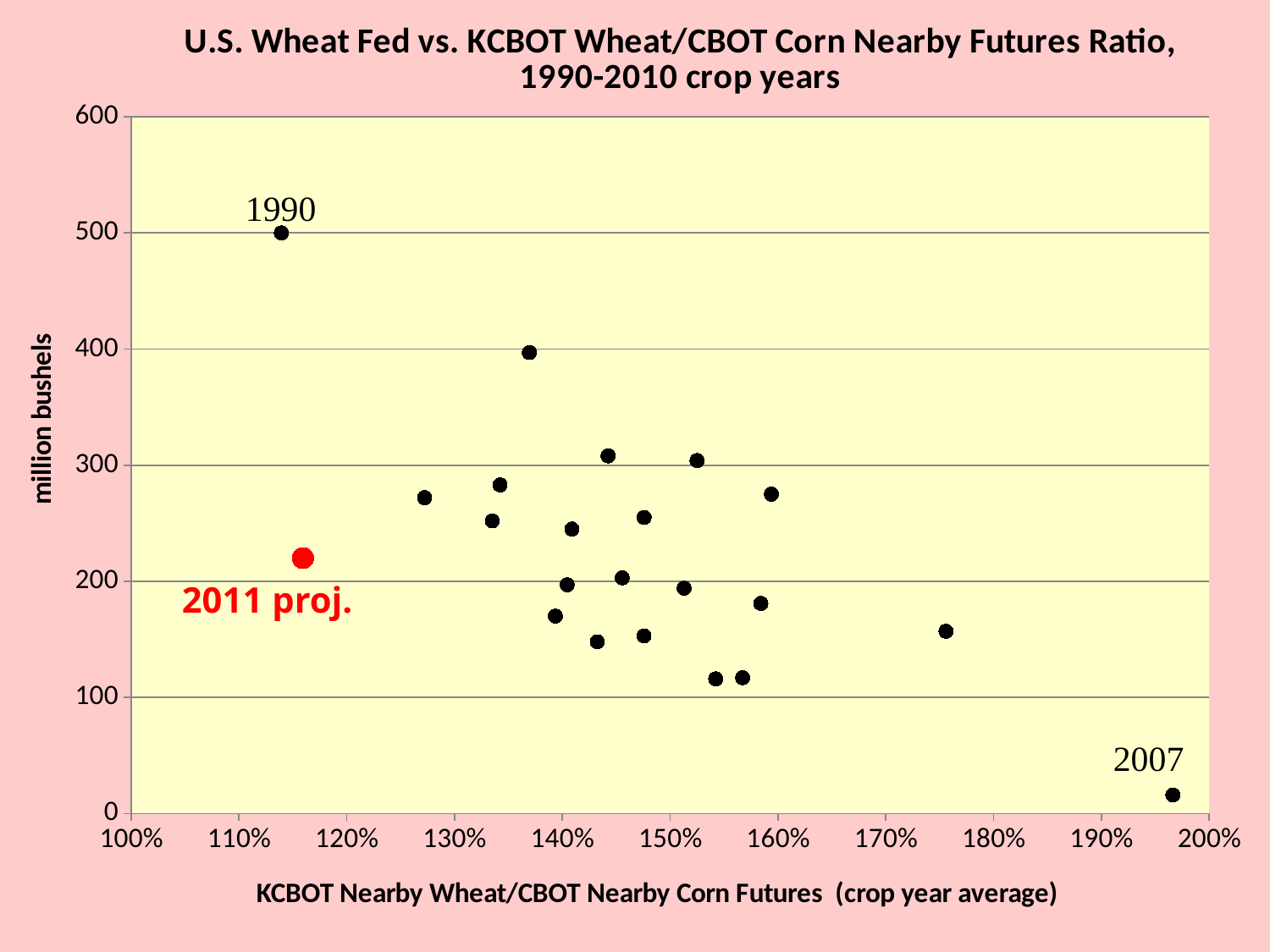
Which labeled point has the lowest value in million bushels? 2007 Is the futures ratio for the 2011 proj. point greater or less than 120%? less Is the futures ratio for the 2007 point greater or less than 190%? greater What kind of chart is shown on the slide? scatter chart Is the million bushels value for the 2011 proj. point greater or less than 200? greater Which has the larger futures ratio, the 2007 point or the 1990 point? 2007 What is the label of the vertical axis? million bushels Which has the larger million bushels value, the 1990 point or the 2011 proj. point? 1990 What is the title of the chart? U.S. Wheat Fed vs. KCBOT Wheat/CBOT Corn Nearby Futures Ratio, 1990-2010 crop years Which labeled point has the highest value in million bushels? 1990